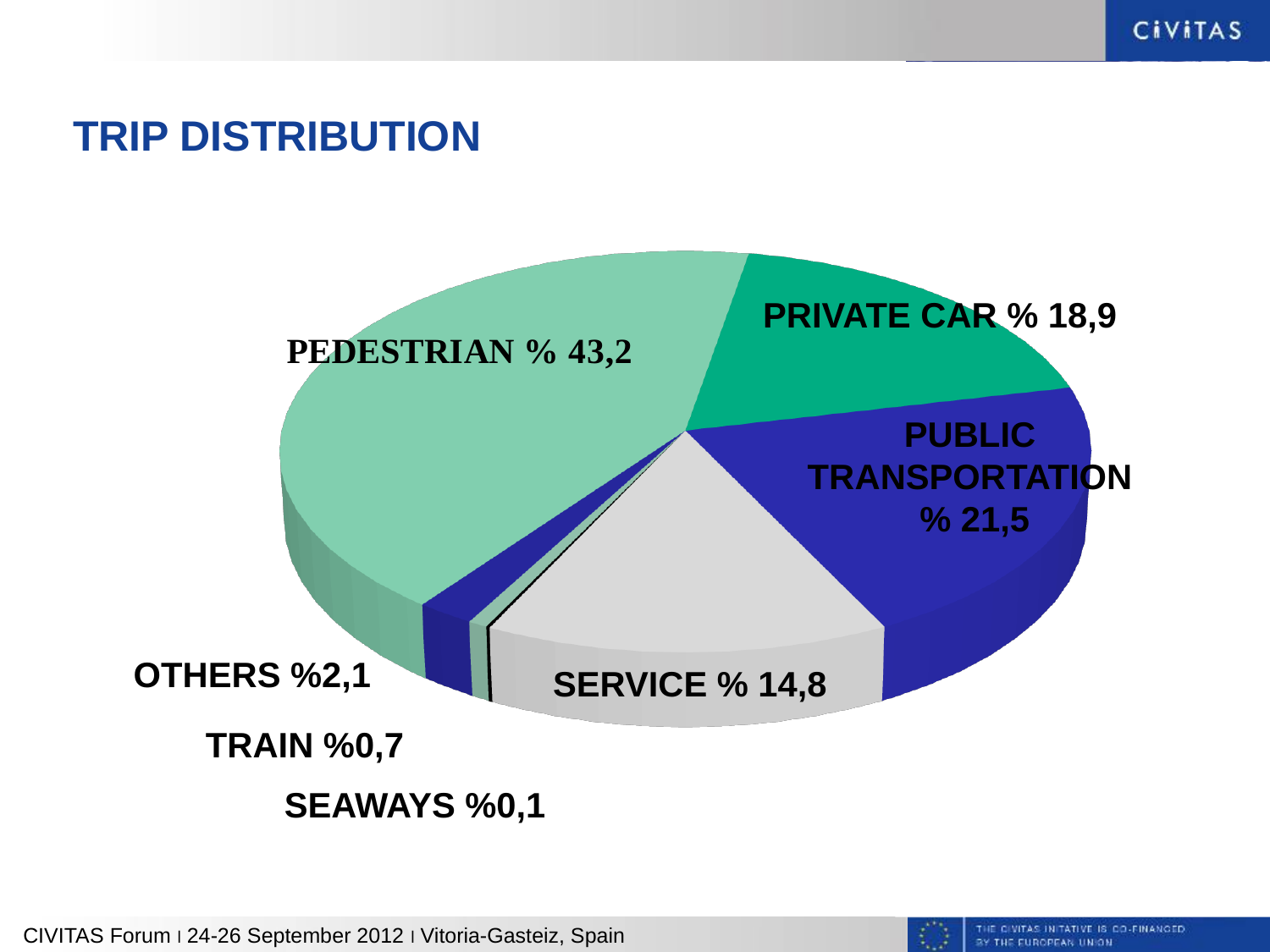
What kind of chart is shown on the slide? pie chart Which category has the largest share of trips? PEDESTRIAN What is the title of the chart? TRIP DISTRIBUTION What share of trips is labelled for SERVICE? % 14,8 What share of trips is labelled for TRAIN? %0,7 What share of trips is labelled for PUBLIC TRANSPORTATION? % 21,5 Which has a larger share, PUBLIC TRANSPORTATION or PRIVATE CAR? PUBLIC TRANSPORTATION Which category has the smallest share of trips? SEAWAYS How many categories are shown in the pie chart? 7 What share of trips is labelled for PEDESTRIAN? % 43,2 What is the difference in percentage points between the PEDESTRIAN share and the PUBLIC TRANSPORTATION share? 21,7 What share of trips is labelled for PRIVATE CAR? % 18,9